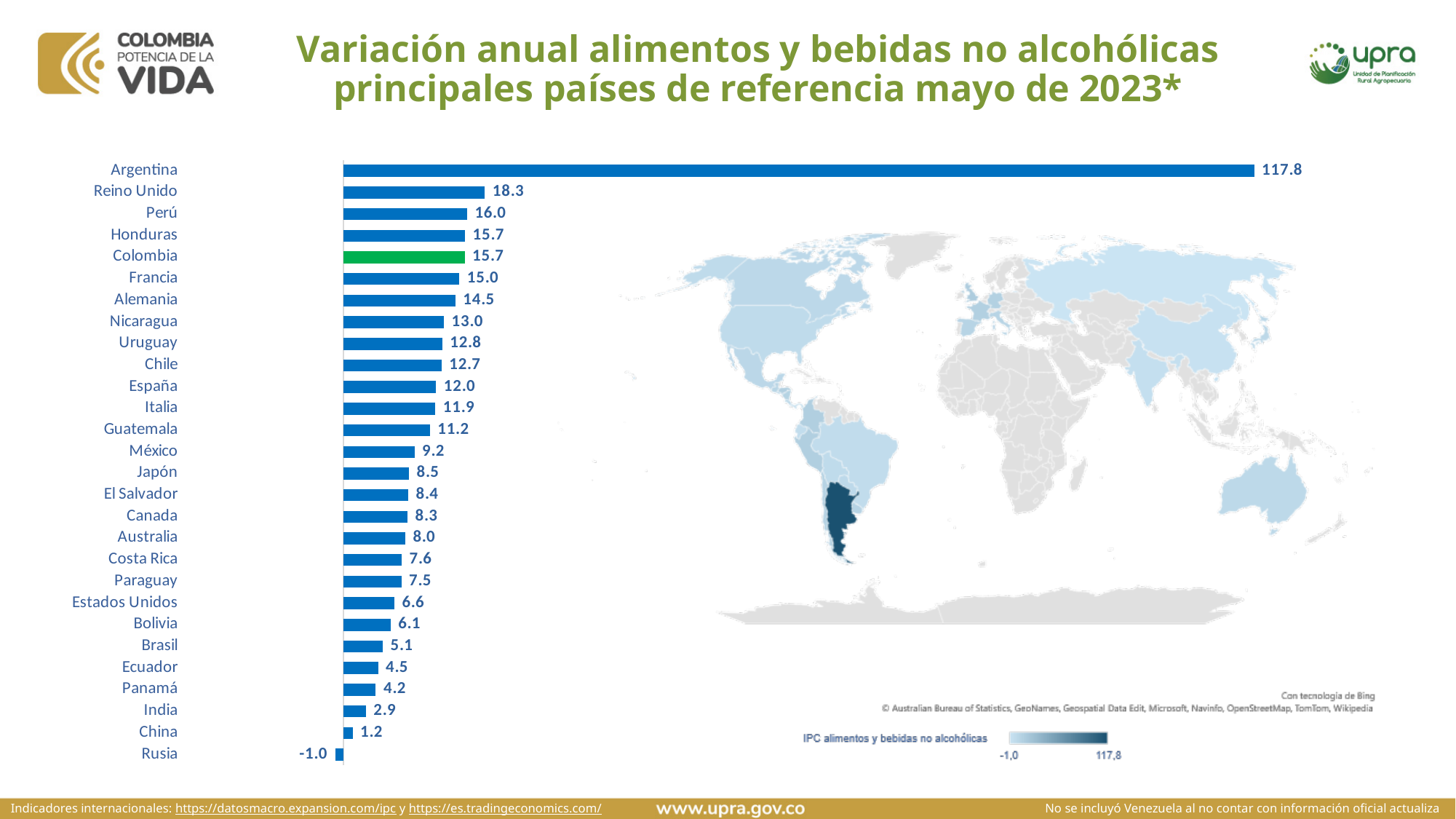
In the bar chart, what is the value for Colombia? 15.7 In the bar chart, which has a larger value, Brasil or Ecuador? Brasil What kind of chart is on the left side of the slide? Bar chart In the bar chart, what is the value for Estados Unidos? 6.6 In the bar chart, what is the value for Reino Unido? 18.3 In the bar chart, which has a larger value, México or Japón? México In the bar chart, which country has the highest value? Argentina In the bar chart, which country's bar is coloured green instead of blue? Colombia In the bar chart, which country has the lowest value? Rusia In the bar chart, what is the difference between the values for Argentina and Reino Unido? 99.5 In the bar chart, what is the difference between the values for Perú and Francia? 1.0 How many countries are shown in the bar chart? 28